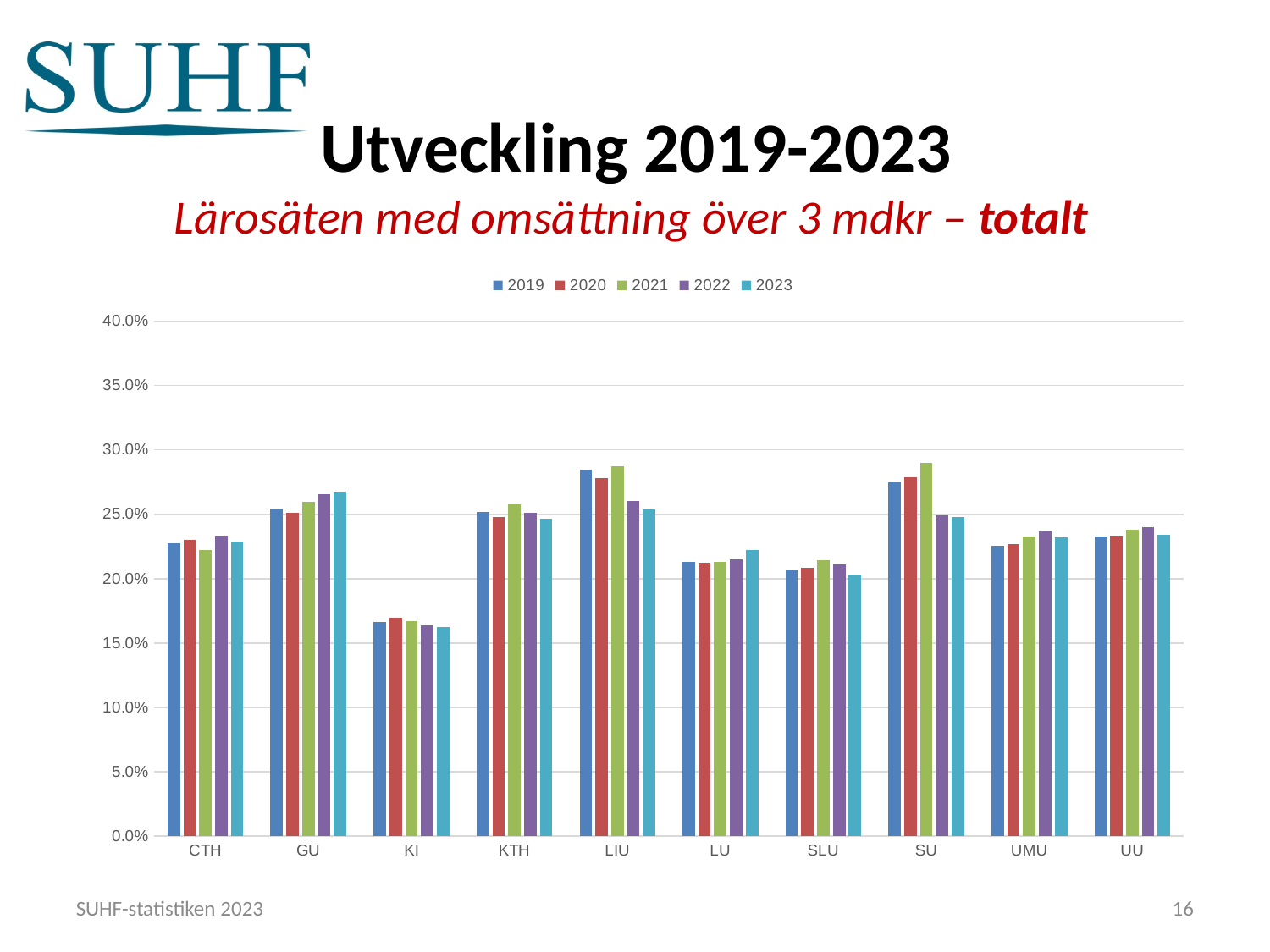
What kind of chart is shown on the slide? bar chart Is the value for KI in 2019 greater or less than 20.0%? less Is the value for SU in 2021 greater or less than 25.0%? greater What is the main title of the chart slide? Utveckling 2019-2023 For LIU, do the values rise or fall from 2021 to 2023? fall For KTH, which year has the highest value? 2021 Which institution has the lowest values across all years? KI How many series does the legend list? 5 Is the value for GU in 2023 greater or less than 25.0%? greater For SU, which year has the highest value? 2021 How many institutions (categories) are shown on the x axis? 10 Which is larger, the 2023 value for LIU or the 2023 value for UMU? LIU